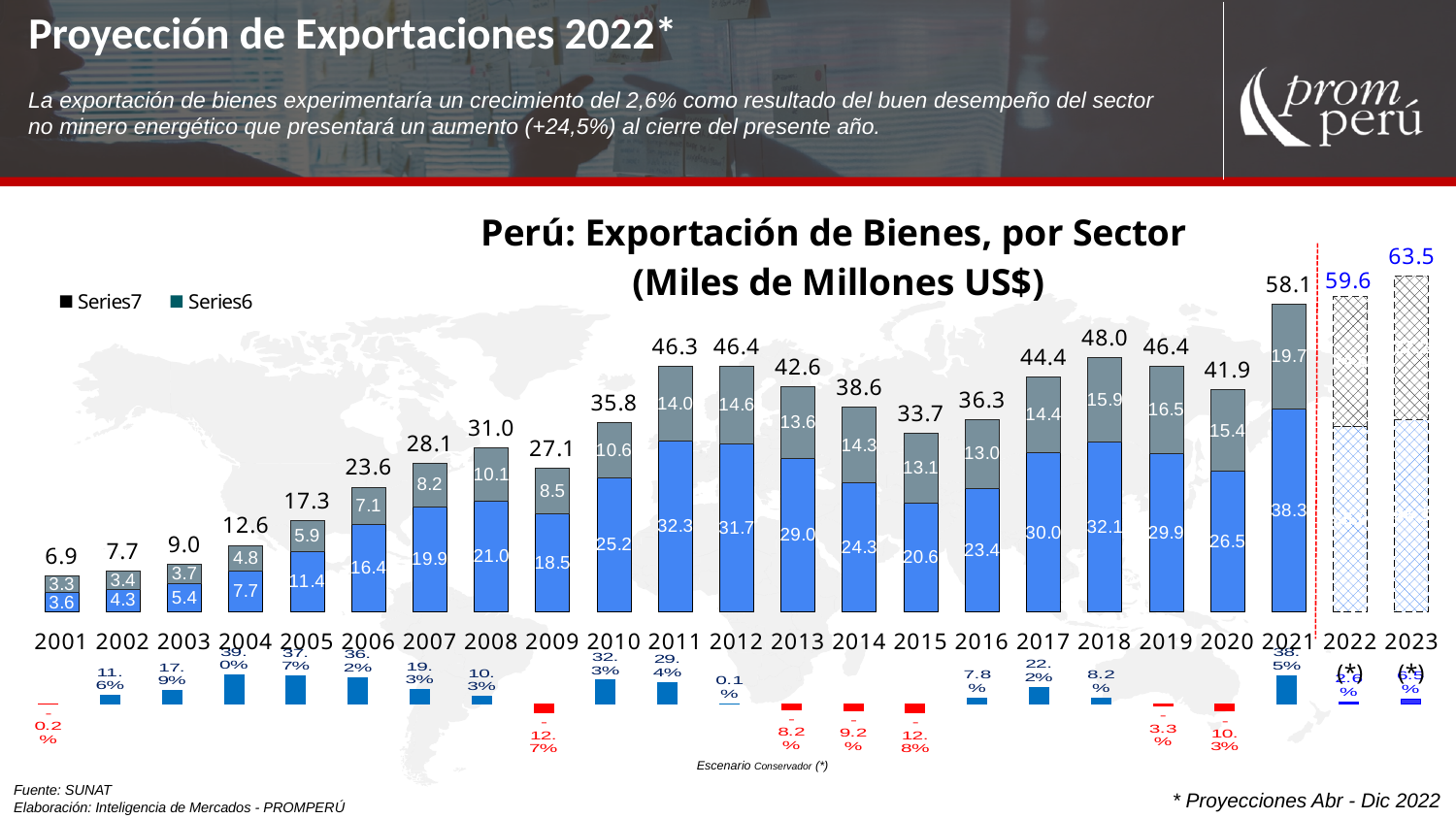
In the 'Perú: Exportación de Bienes, por Sector' chart, what is the difference between the totals for 2022 and 2021? 1.5 In the 'Perú: Exportación de Bienes, por Sector' chart, what is the value of the blue (Series6) segment for 2021? 38.3 What is the total value shown for 2021 in the 'Perú: Exportación de Bienes, por Sector' chart? 58.1 What unit is given in the title of the 'Perú: Exportación de Bienes, por Sector' chart? Miles de Millones US$ What kind of chart is 'Perú: Exportación de Bienes, por Sector'? Stacked bar chart Which year has the lowest total in the 'Perú: Exportación de Bienes, por Sector' chart? 2001 How many years are shown on the x axis of the 'Perú: Exportación de Bienes, por Sector' chart? 23 Which year has the highest total in the 'Perú: Exportación de Bienes, por Sector' chart? 2023 In the 'Perú: Exportación de Bienes, por Sector' chart, what is the value of the grey (Series7) segment for 2018? 15.9 In the 'Perú: Exportación de Bienes, por Sector' chart, which year has a larger total, 2015 or 2016? 2016 How many series does the legend of the 'Perú: Exportación de Bienes, por Sector' chart list? 2 What is the total value shown for 2023 in the 'Perú: Exportación de Bienes, por Sector' chart? 63.5